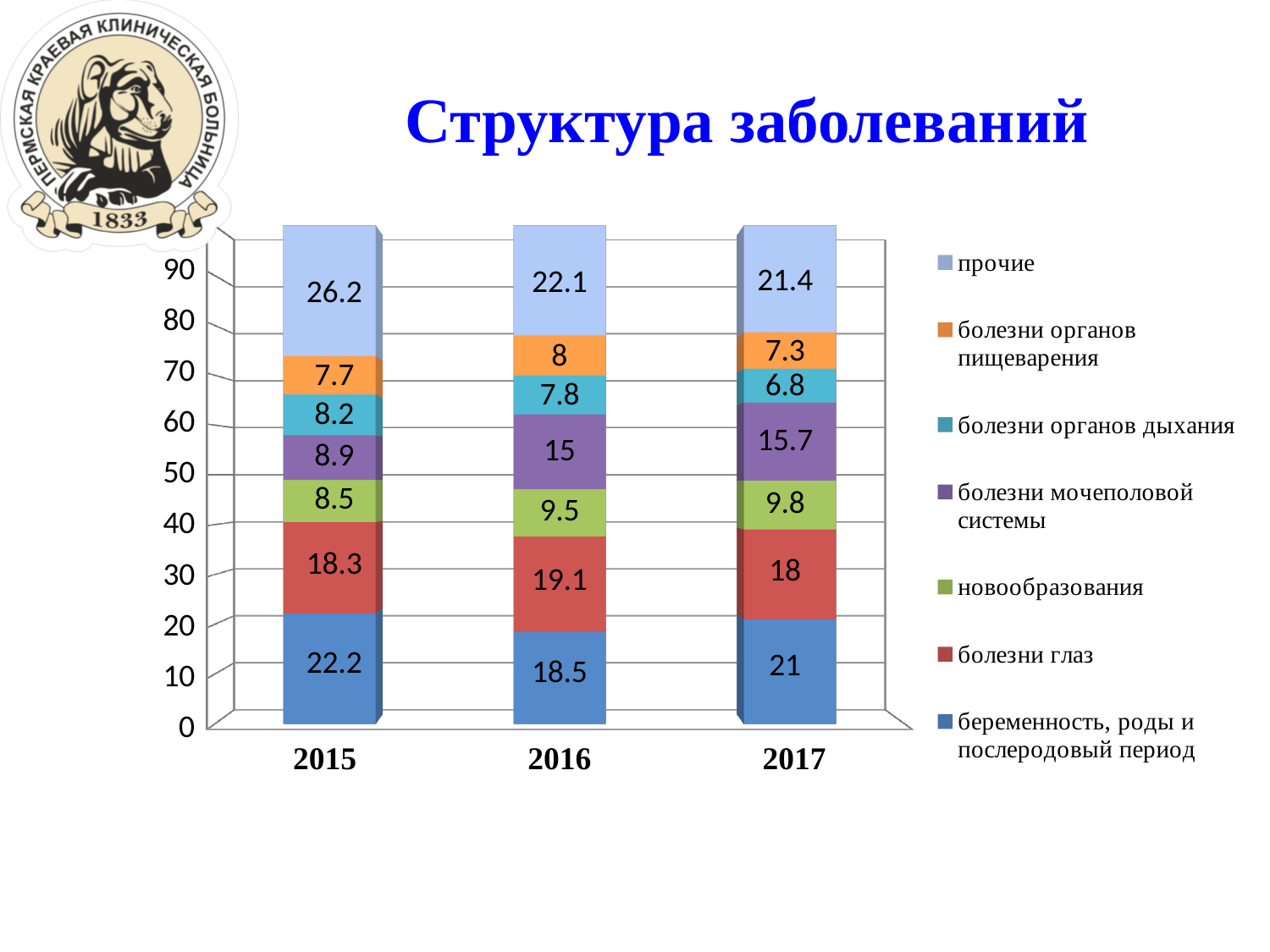
Which is larger: 'новообразования' in 2016 or 'новообразования' in 2017? 2017 What is the difference between the 'прочие' values for 2015 and 2017? 4.8 In which year is the value for 'болезни органов дыхания' the lowest? 2017 How many series does the legend list? 7 What is the value for 'болезни глаз' in 2016? 19.1 What is the chart's title? Структура заболеваний How many years (categories) are shown on the x axis? 3 What is the value for 'прочие' in 2015? 26.2 What is the total of the stacked bar for 2016? 100 What kind of chart is shown on the slide? stacked bar chart What is the value for 'болезни мочеполовой системы' in 2017? 15.7 In which year is the value for 'беременность, роды и послеродовый период' the highest? 2015